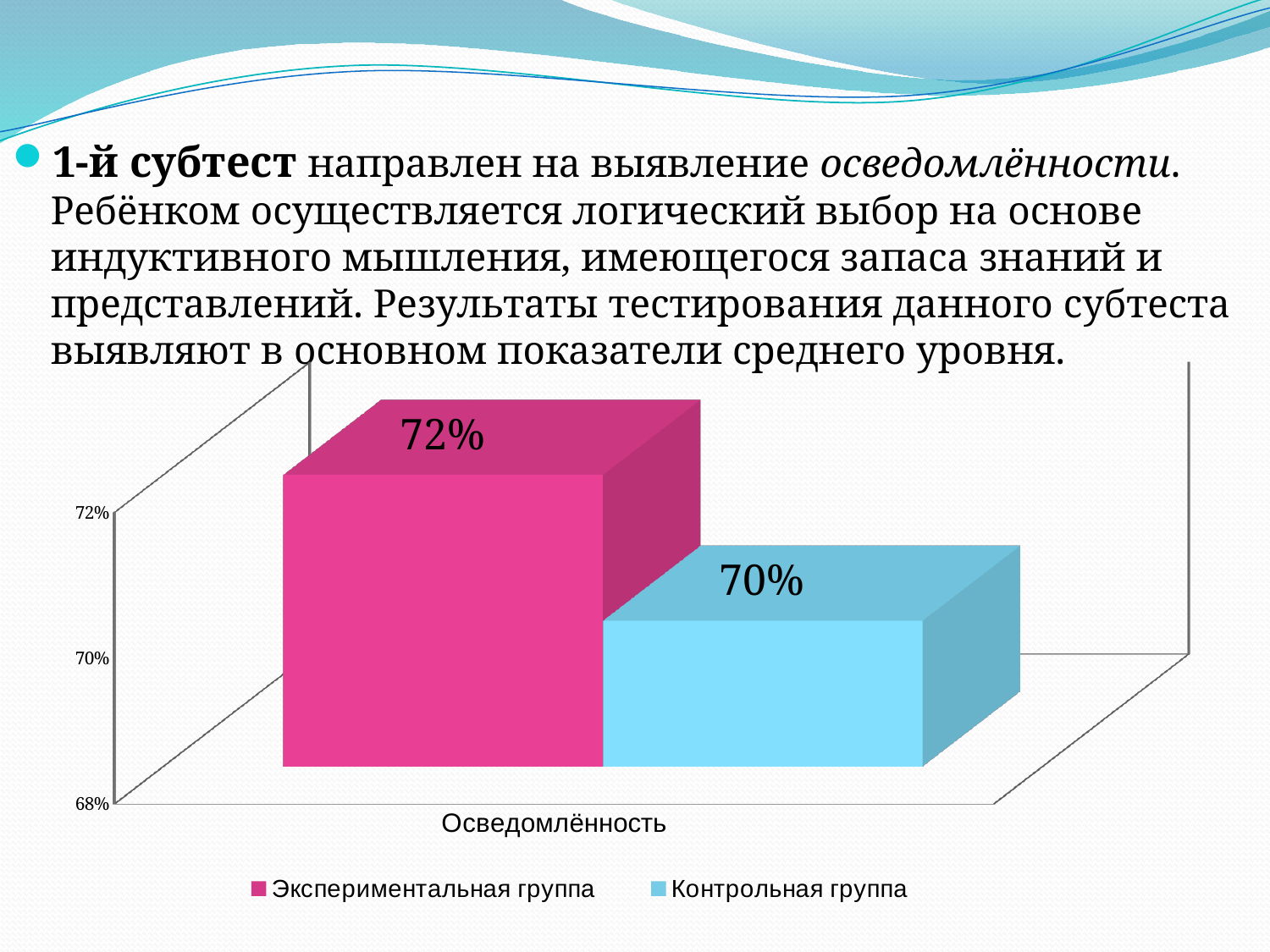
What is the category label on the x axis of the chart? Осведомлённость What colour is the bar for Контрольная группа? light blue How many categories are shown on the x axis? 1 How many series does the legend list? 2 What is the value for Контрольная группа in the Осведомлённость chart? 70% What kind of chart is shown on the slide? bar chart Which group has the higher value for Осведомлённость? Экспериментальная группа What is the value for Экспериментальная группа in the Осведомлённость chart? 72% What is the difference between the Экспериментальная группа and Контрольная группа values? 2% Which group has the lower value for Осведомлённость? Контрольная группа Is the value for Экспериментальная группа larger or smaller than the value for Контрольная группа? larger